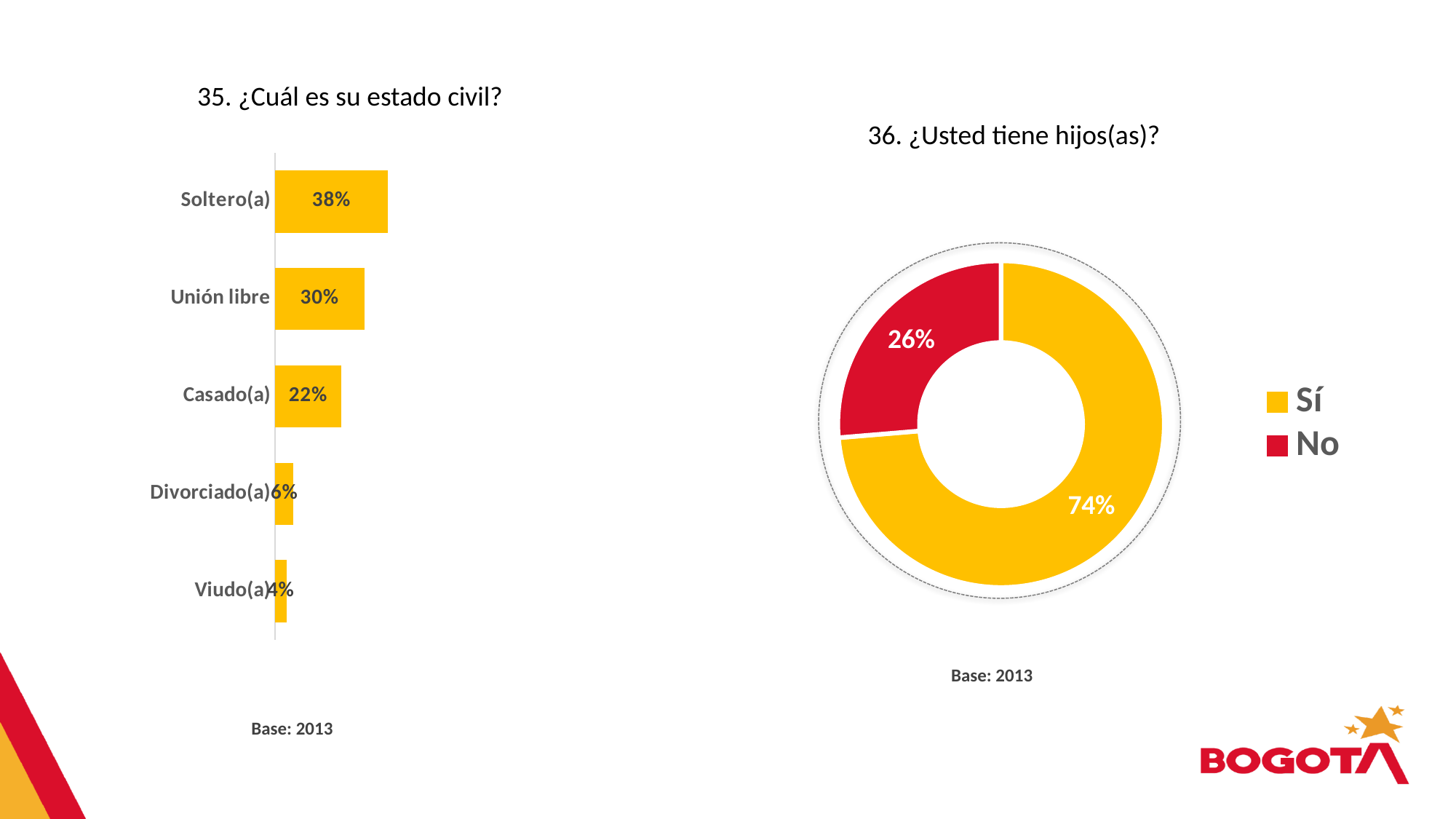
In the chart '35. ¿Cuál es su estado civil?', which category has the lowest value? Viudo(a) How many entries does the legend list in the chart '36. ¿Usted tiene hijos(as)?'? 2 In the chart '35. ¿Cuál es su estado civil?', which category has the highest value? Soltero(a) In the chart '36. ¿Usted tiene hijos(as)?', what is the value for 'Sí'? 74% In the chart '36. ¿Usted tiene hijos(as)?', what share of the pie is 'No'? 26% In the chart '35. ¿Cuál es su estado civil?', what is the value for Unión libre? 30% In the chart '35. ¿Cuál es su estado civil?', what is the value for Soltero(a)? 38% In the chart '35. ¿Cuál es su estado civil?', what is the difference between Soltero(a) and Casado(a)? 16% In the chart '35. ¿Cuál es su estado civil?', what is the value for Casado(a)? 22% In the chart '35. ¿Cuál es su estado civil?', which is larger, Divorciado(a) or Viudo(a)? Divorciado(a) What kind of chart is '35. ¿Cuál es su estado civil?'? Bar chart How many categories are shown in the chart '35. ¿Cuál es su estado civil?'? 5